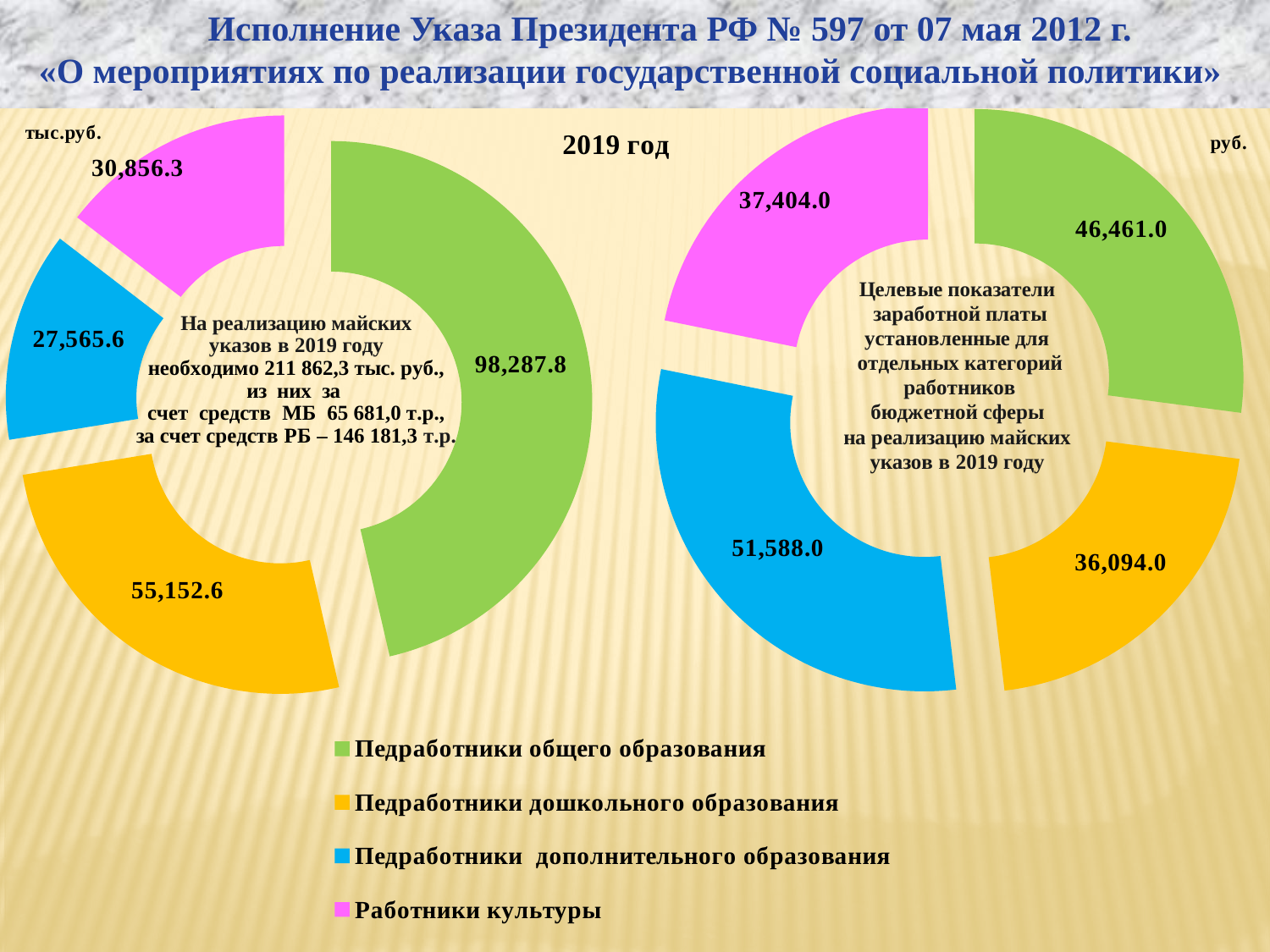
On the left chart (тыс.руб.), which is larger: Работники культуры or Педработники дополнительного образования? Работники культуры On the left chart (тыс.руб.), what is the value for Работники культуры? 30,856.3 On the right chart (руб.), which category has the highest value? Педработники дополнительного образования How many categories does the legend list? 4 On the right chart (руб.), what is the difference between Педработники дополнительного образования and Педработники общего образования? 5,127.0 On the left chart (тыс.руб.), what is the value for Педработники общего образования? 98,287.8 On the left chart (тыс.руб.), which category has the highest value? Педработники общего образования On the right chart (руб.), which category has the lowest value? Педработники дошкольного образования On the left chart (тыс.руб.), what is the difference between Педработники общего образования and Педработники дошкольного образования? 43,135.2 On the right chart (руб.), what is the value for Педработники дошкольного образования? 36,094.0 What kind of charts are shown on the slide? Doughnut (pie) charts On the right chart (руб.), what is the value for Педработники дополнительного образования? 51,588.0